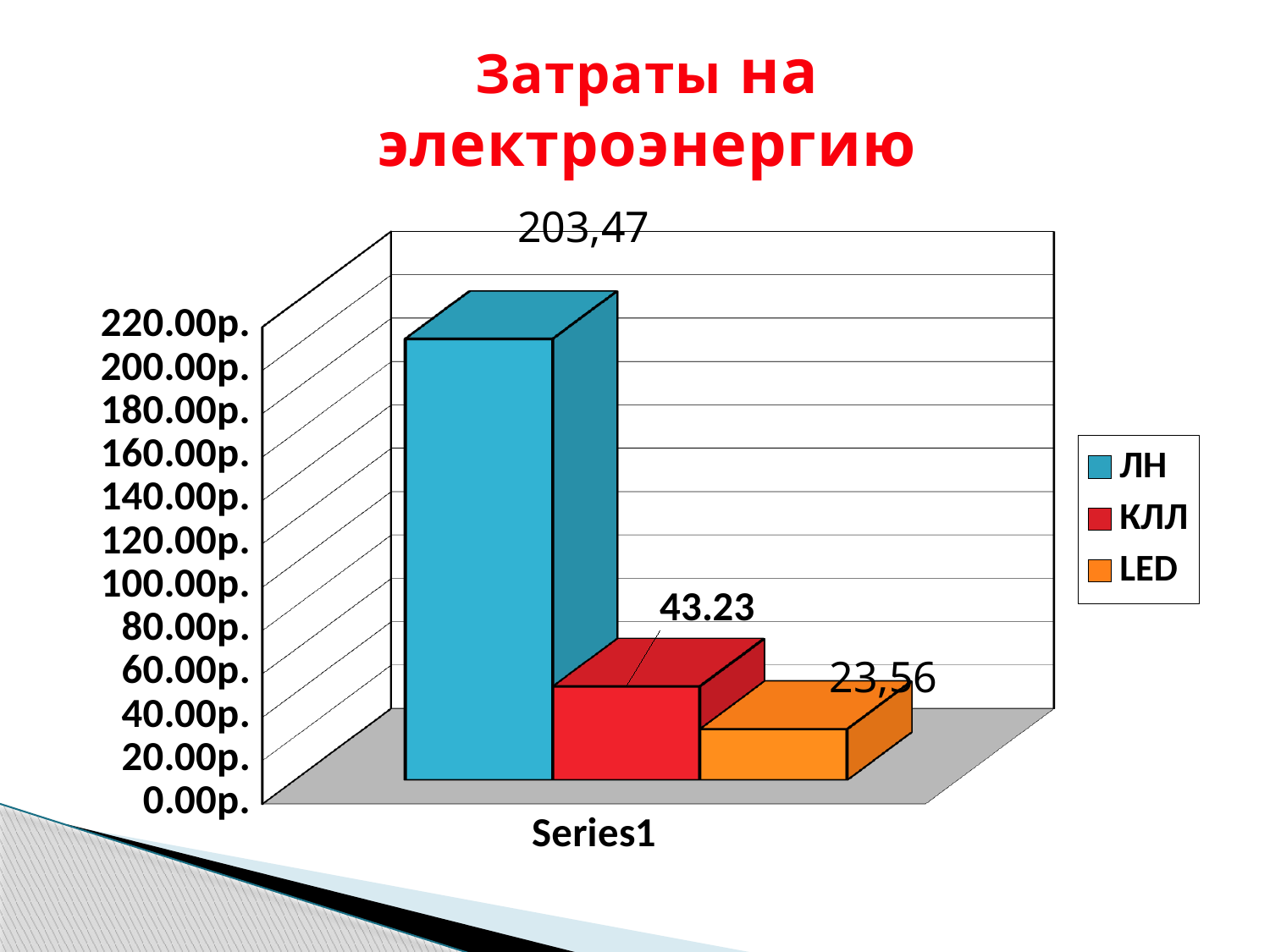
Which series has the lowest value? LED Which is larger, the value for КЛЛ or the value for LED? КЛЛ How many series does the legend list? 3 What is the value shown for ЛН? 203,47 What is the value shown for КЛЛ? 43.23 What is the title of the slide? Затраты на электроэнергию Is the value for LED greater or less than 40.00р.? less What is the difference between the values for ЛН and КЛЛ? 160.24 Which series has the highest value? ЛН What kind of chart is shown on the slide? bar chart Is the value for ЛН greater or less than 180.00р.? greater What is the value shown for LED? 23,56